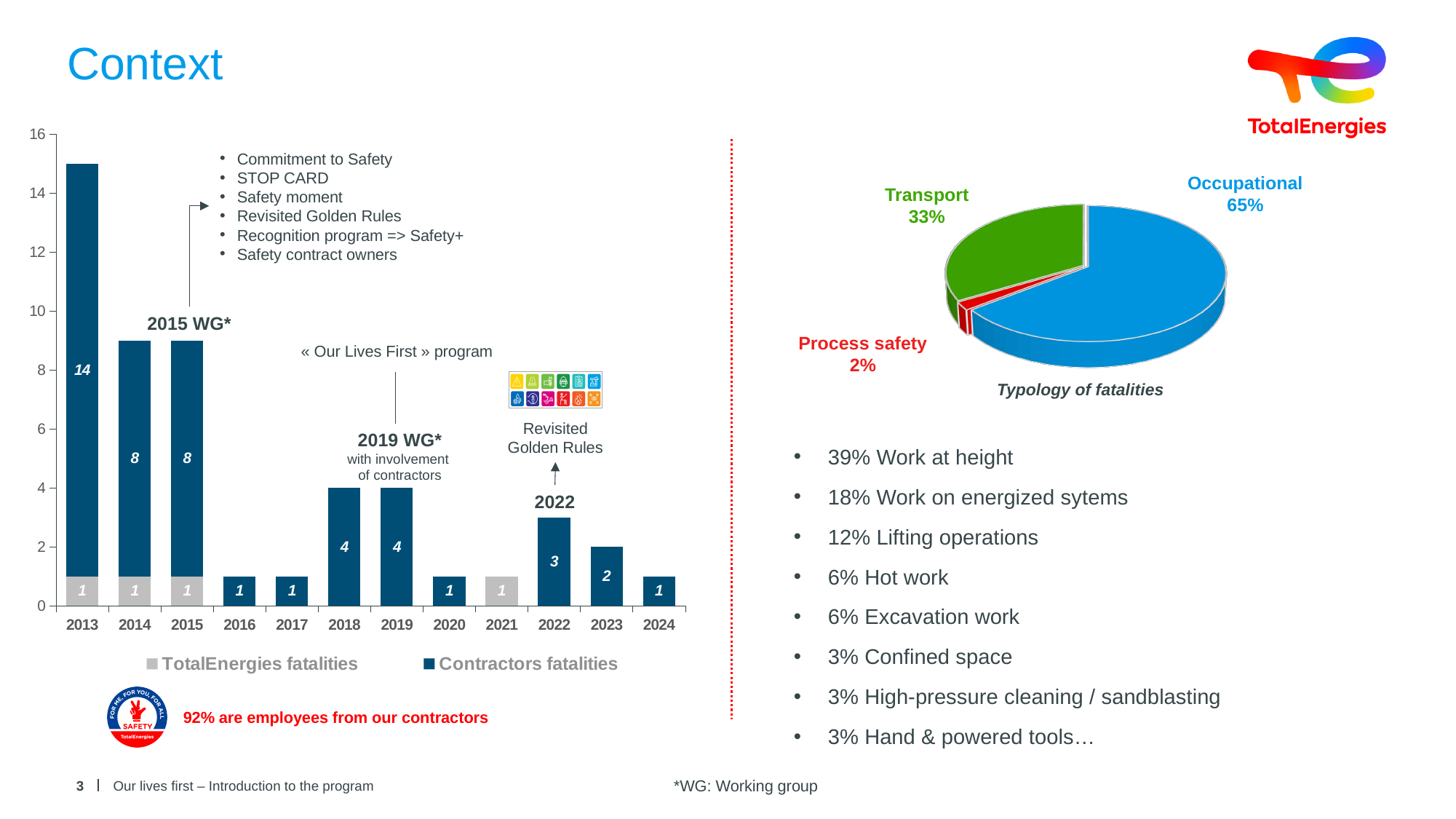
In the pie chart 'Typology of fatalities', what share is Transport? 33% In the bar chart on the left, do the Contractors fatalities values rise or fall from 2013 to 2016? fall In the bar chart on the left, how many series does the legend list? 2 In the bar chart on the left, what is the value for Contractors fatalities in 2022? 3 In the bar chart on the left, what is the value for Contractors fatalities in 2013? 14 In the bar chart on the left, what is the total of the stacked bar for 2013? 15 In the bar chart on the left, what is the total of the stacked bar for 2014? 9 In the pie chart 'Typology of fatalities', which category has the smallest share? Process safety In the bar chart on the left, what is the difference between Contractors fatalities in 2018 and in 2023? 2 In the bar chart on the left, how many years are shown on the x axis? 12 In the bar chart on the left, which is larger: Contractors fatalities in 2019 or in 2022? 2019 In the bar chart on the left, which year has the highest total fatalities? 2013